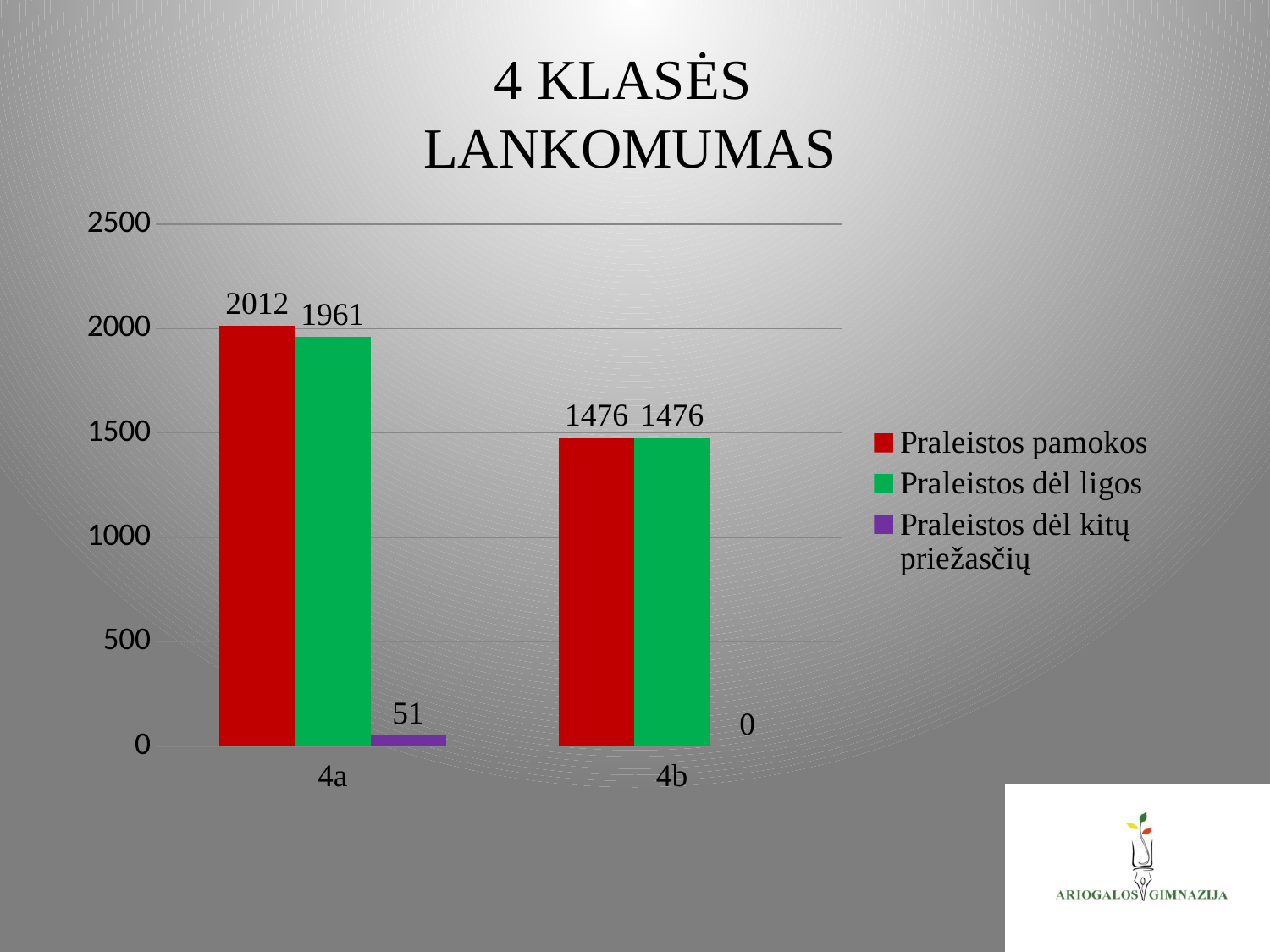
What is the value of Praleistos dėl ligos for 4b? 1476 What is the difference in Praleistos pamokos between 4a and 4b? 536 How many classes are shown on the x axis? 2 What is the difference between Praleistos pamokos and Praleistos dėl ligos for 4a? 51 What kind of chart is shown on the slide? Bar chart What is the value of Praleistos pamokos for 4a? 2012 Which class has the higher value for Praleistos pamokos? 4a What is the value of Praleistos dėl kitų priežasčių for 4a? 51 Is the value of Praleistos dėl ligos for 4a greater or less than 2000? less How many series does the legend list? 3 What is the value of Praleistos dėl kitų priežasčių for 4b? 0 Is the value of Praleistos dėl ligos for 4a larger than the value for 4b? Yes